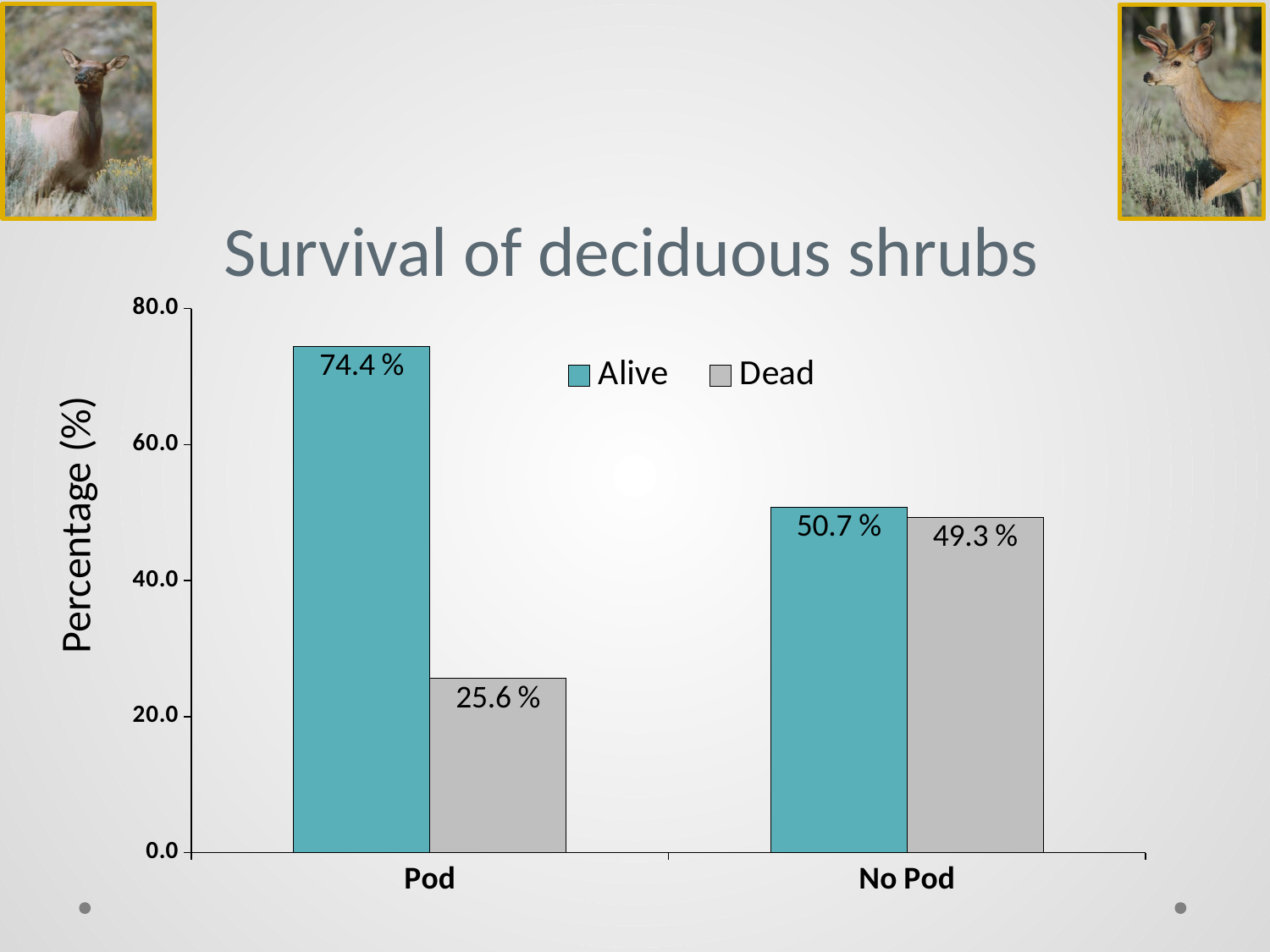
What is the Dead percentage for No Pod? 49.3 % Which category has the lowest Dead percentage? Pod Which category has the highest Alive percentage? Pod What is the Alive percentage for Pod? 74.4 % How many categories are shown on the x axis? 2 What is the Alive percentage for No Pod? 50.7 % What is the difference between the Alive and Dead percentages for Pod? 48.8 % How many series does the legend list? 2 What kind of chart is shown on the slide? Bar chart What is the title of the chart? Survival of deciduous shrubs Is the Alive percentage larger for Pod or for No Pod? Pod What is the Dead percentage for Pod? 25.6 %